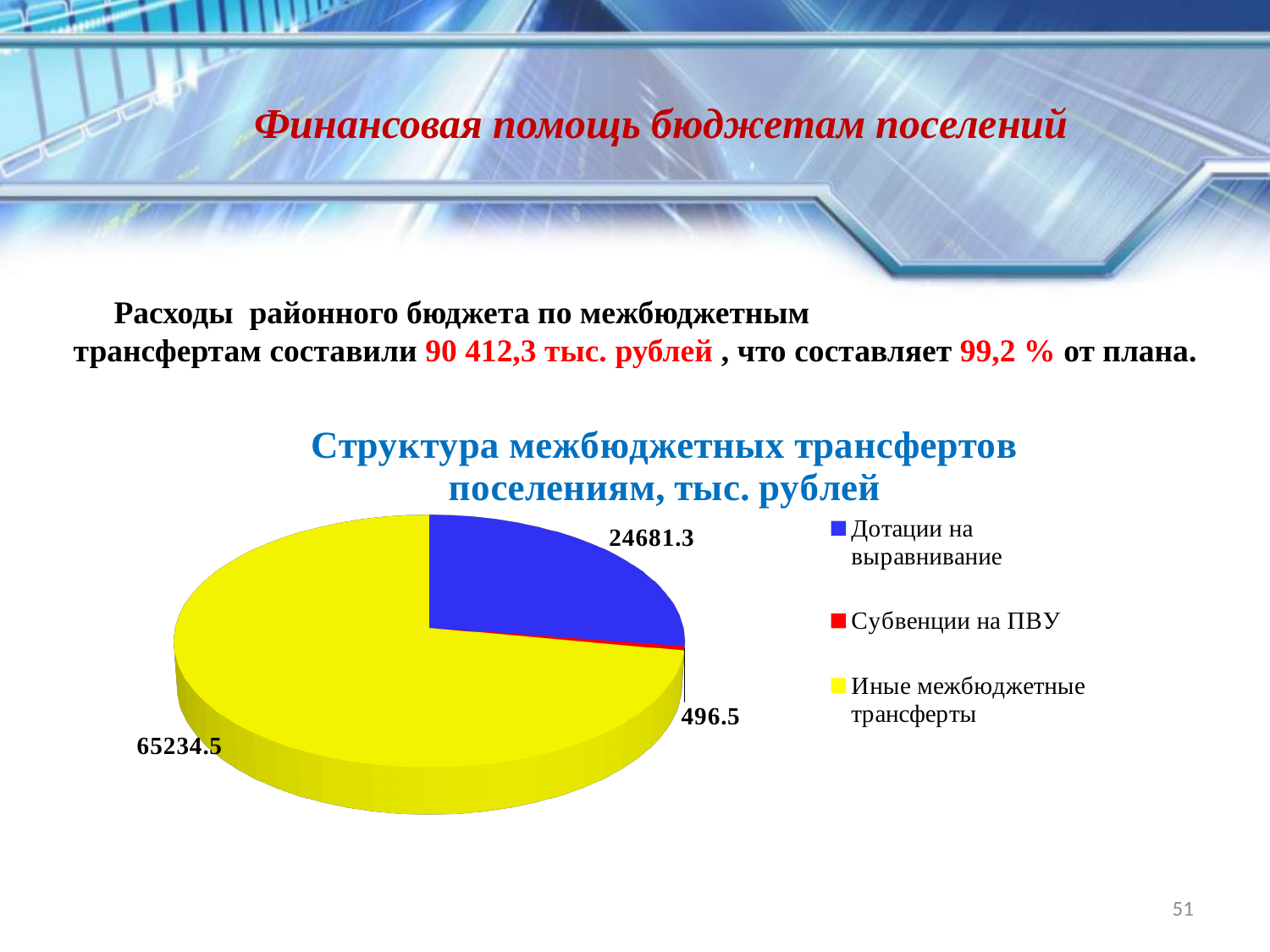
What is the difference between the values for Иные межбюджетные трансферты and Дотации на выравнивание? 40553.2 What is the value for Иные межбюджетные трансферты in the pie chart? 65234.5 Which category has the smallest slice in the pie chart? Субвенции на ПВУ What colour is the slice for Дотации на выравнивание? Blue How many categories does the pie chart show? 3 What is the value for Субвенции на ПВУ in the pie chart? 496.5 What share of the pie does Иные межбюджетные трансферты represent? 72.2% What type of chart is shown on the slide? Pie chart What is the difference between the values for Дотации на выравнивание and Субвенции на ПВУ? 24184.8 What is the value for Дотации на выравнивание in the pie chart? 24681.3 Which category has the largest slice in the pie chart? Иные межбюджетные трансферты Which is larger: Дотации на выравнивание or Субвенции на ПВУ? Дотации на выравнивание